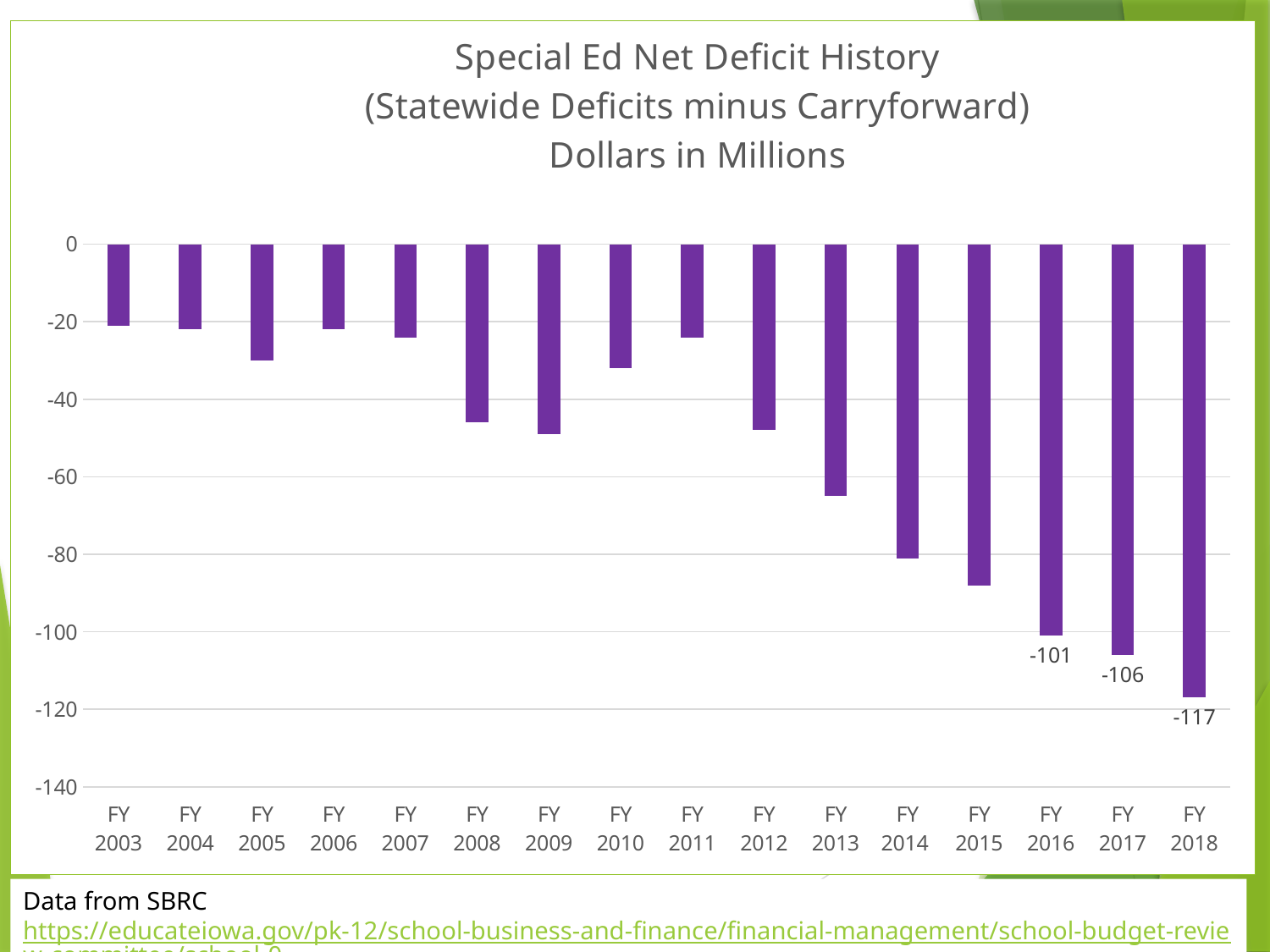
How many fiscal years are shown on the x axis? 16 What is the value for FY 2017? -106 What is the title of the chart? Special Ed Net Deficit History (Statewide Deficits minus Carryforward) Dollars in Millions Is the value for FY 2013 greater or less than -60? less Which is larger, the value for FY 2012 or the value for FY 2015? FY 2012 What is the value for FY 2016? -101 What is the difference between the values for FY 2016 and FY 2018? 16 Is the value for FY 2011 greater or less than -40? greater What is the value for FY 2018? -117 What kind of chart is this? Bar chart Do the values generally rise or fall from FY 2003 to FY 2018? Fall Which fiscal year has the lowest (most negative) value? FY 2018